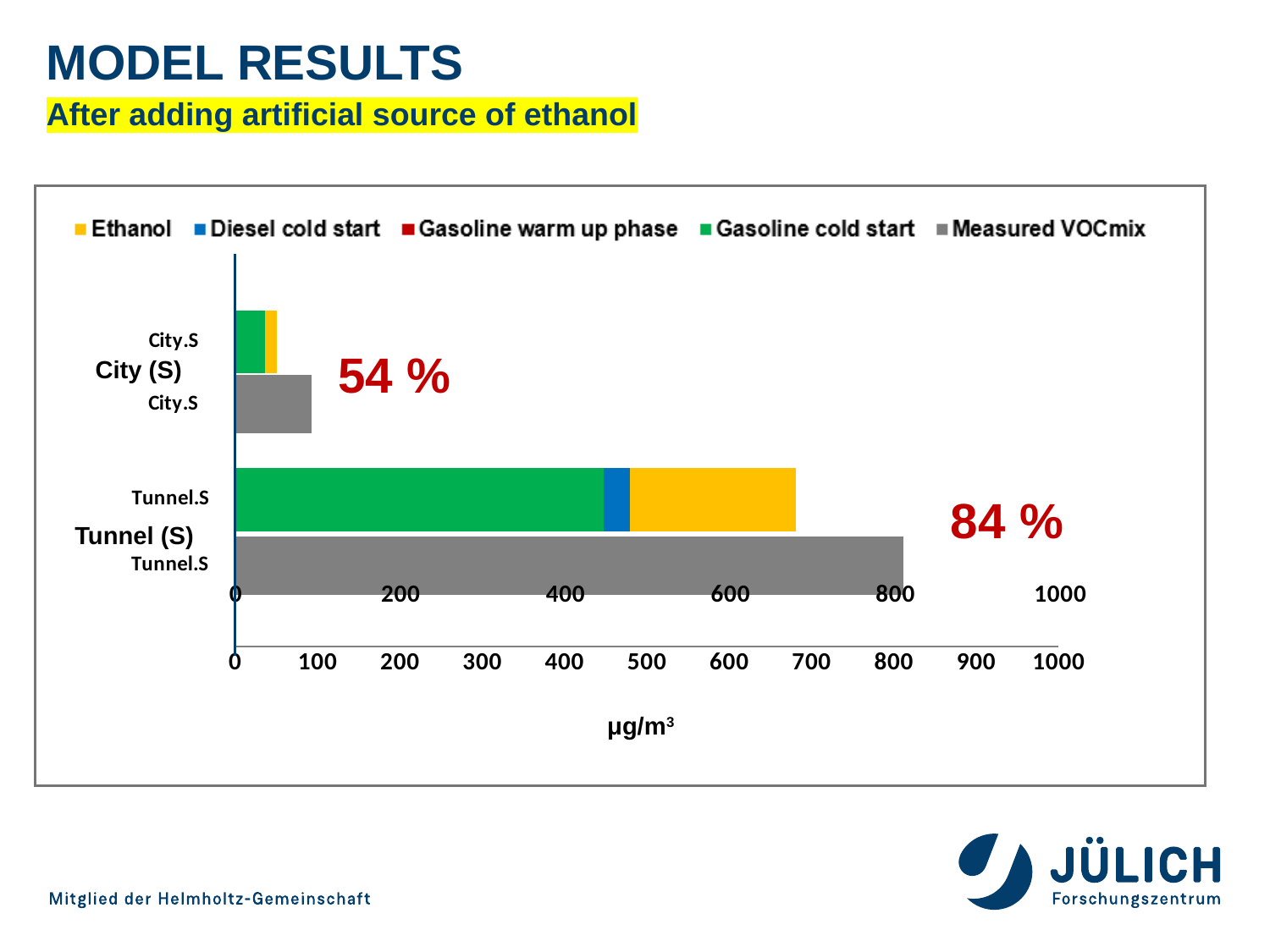
What unit is shown on the horizontal axis of the chart? µg/m³ What kind of chart is shown on the slide? bar chart Which legend entry is shown in grey? Measured VOCmix Which category has the larger Measured VOCmix value, City (S) or Tunnel (S)? Tunnel (S) How many series does the legend list? 5 What percentage is printed next to the Tunnel (S) bars? 84 % Is the Gasoline cold start value for Tunnel (S) greater or less than 300? greater Is the Measured VOCmix value for Tunnel (S) greater or less than 600? greater How many categories are shown on the vertical axis of the chart? 2 What percentage is printed next to the City (S) bars? 54 % Is the Measured VOCmix value for City (S) greater or less than 200? less In the Tunnel (S) stacked bar, which is larger, the Gasoline cold start segment or the Ethanol segment? Gasoline cold start